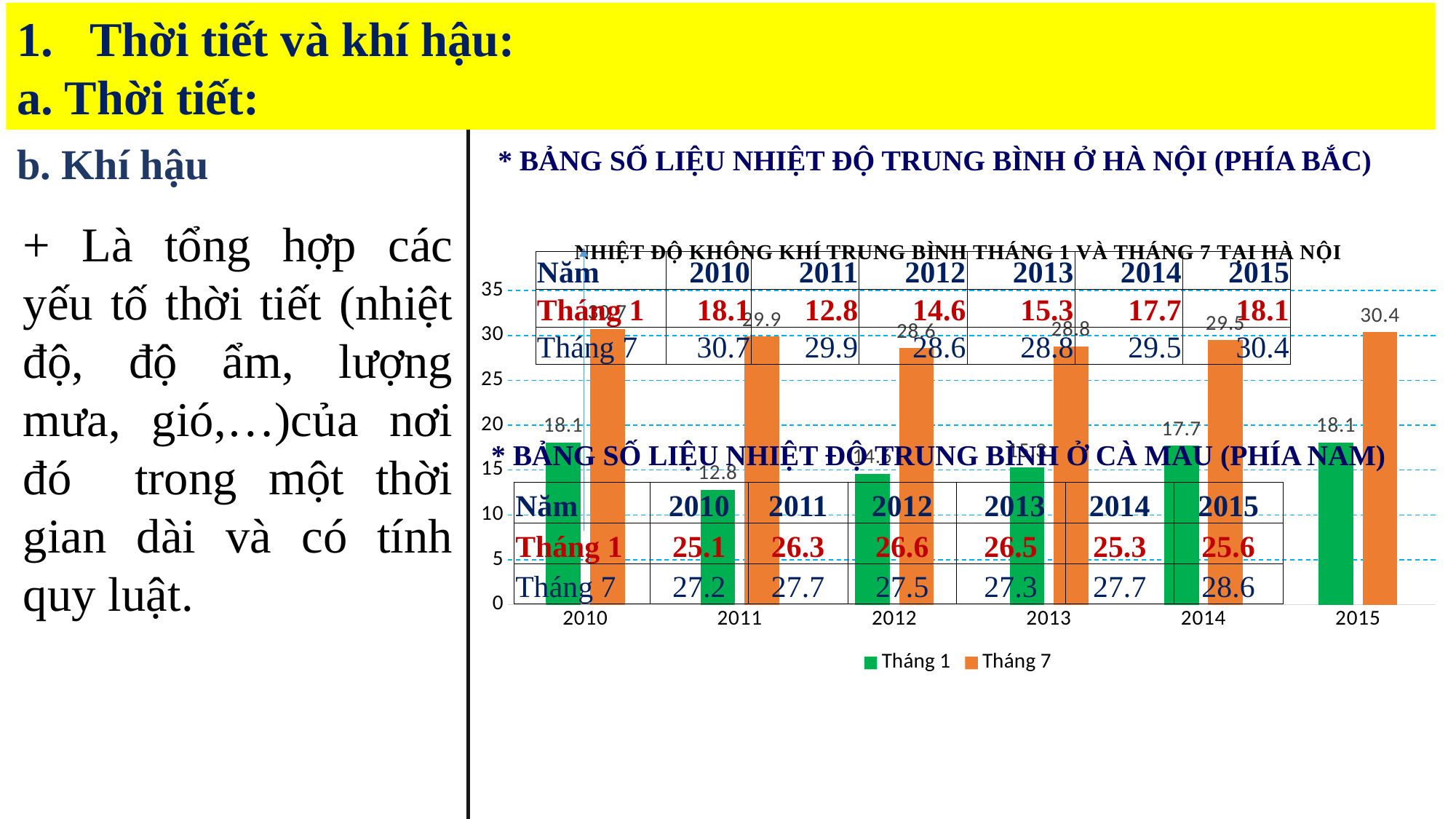
What is the Tháng 1 value for 2011 in the chart? 12.8 What is the difference between the Tháng 7 and Tháng 1 values for 2015? 12.3 What is the Tháng 7 value for 2015 in the chart? 30.4 What kind of chart is shown on the slide? Bar chart Do the Tháng 1 values rise or fall from 2011 to 2015? Rise Which year has the larger Tháng 1 value, 2013 or 2014? 2014 Which year has the lowest Tháng 1 value in the chart? 2011 How many series does the chart legend list? 2 How many years are shown on the x axis of the chart? 6 Is the Tháng 7 value for 2012 greater or less than 25? greater Which year has the highest Tháng 7 value in the chart? 2010 What is the Tháng 7 value for 2014 in the chart? 29.5